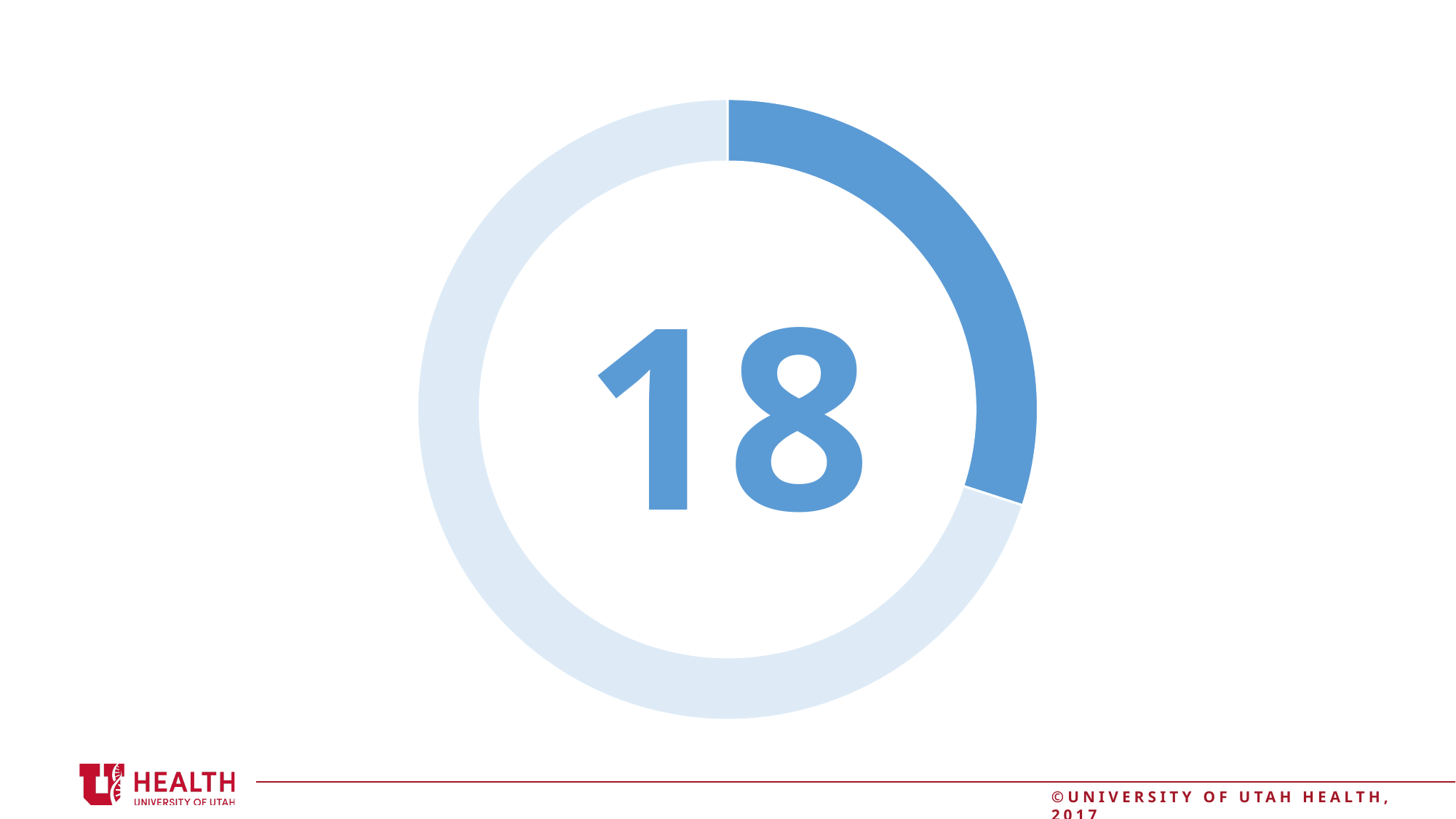
Does the dark blue segment cover more or less than half of the donut chart? Less Which segment of the donut chart is larger, the dark blue one or the light blue one? The light blue one What kind of chart is shown on the slide? Donut chart What number is displayed in the center of the donut chart? 18 What colour is the highlighted (filled) segment of the donut chart? Dark blue Does the donut chart have a legend? No How many segments does the donut chart have? 2